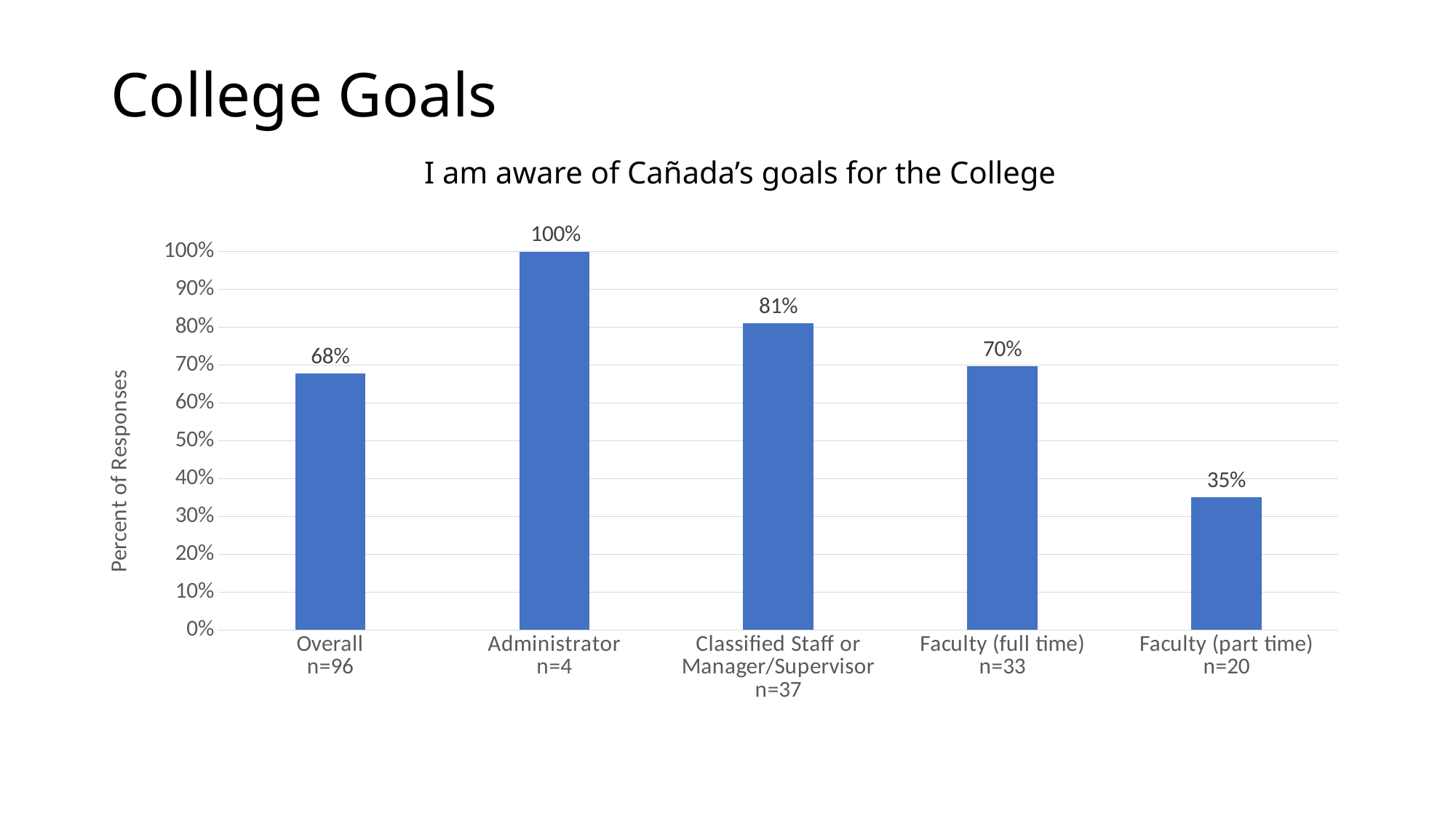
What is the value for Administrator? 100% What is the difference between the Administrator value and the Faculty (part time) value? 65% What is the title of the chart? I am aware of Cañada's goals for the College Which category has the highest value? Administrator What is the value for Faculty (part time)? 35% What is the difference between the Classified Staff or Manager/Supervisor value and the Faculty (full time) value? 11% What kind of chart is shown? Bar chart What is the value for Classified Staff or Manager/Supervisor? 81% What is the Overall value? 68% Which category has the lowest value? Faculty (part time) Which is larger, the value for Faculty (full time) or the value for Overall? Faculty (full time) How many categories are shown on the x axis? 5